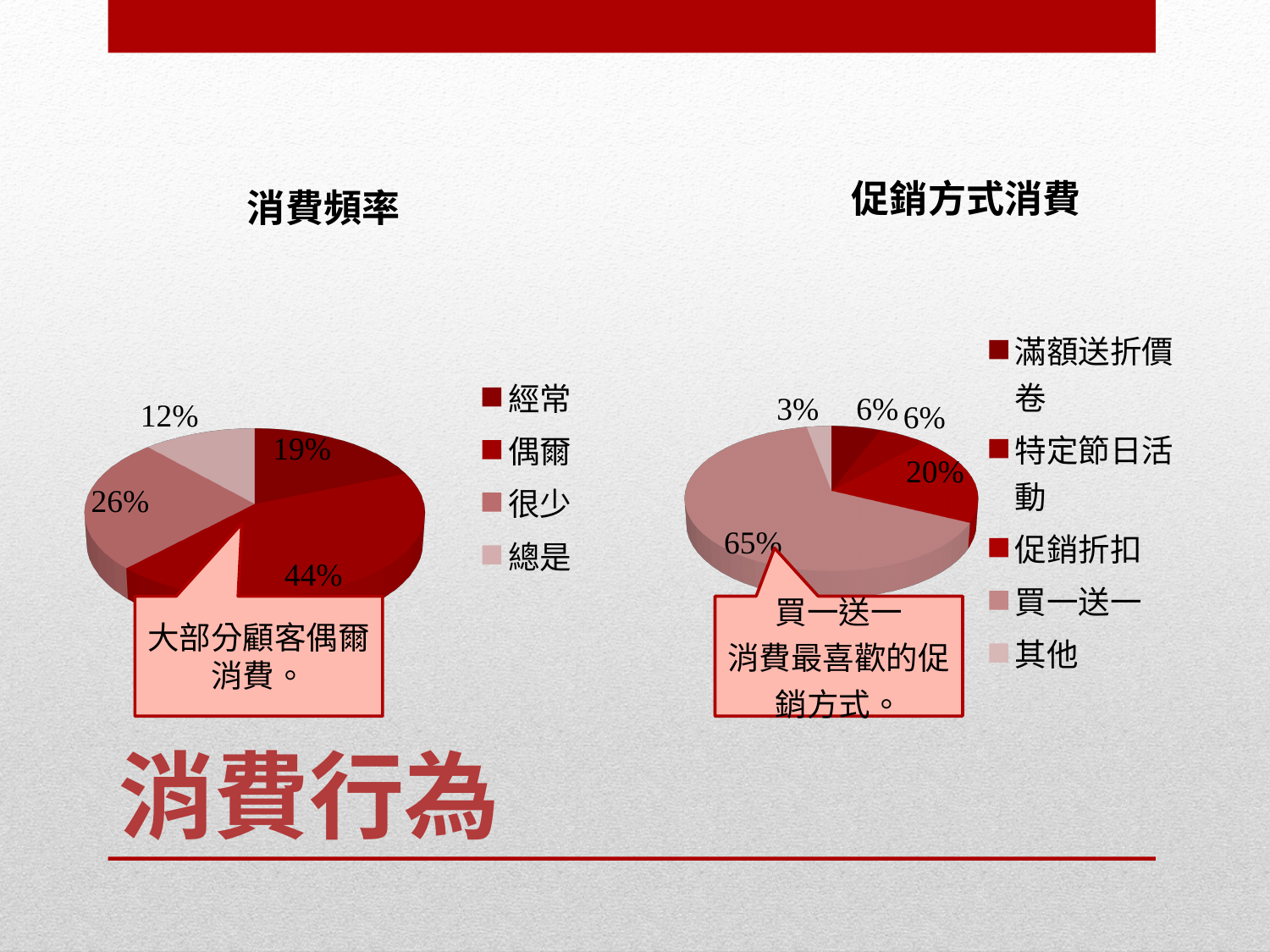
In the 促銷方式消費 chart, what percentage is shown for 促銷折扣? 20% In the 消費頻率 chart, which category has the smallest share? 總是 In the 促銷方式消費 chart, which is larger, 促銷折扣 or 其他? 促銷折扣 In the 消費頻率 chart, what percentage is shown for 偶爾? 44% In the 消費頻率 chart, what is the difference between the shares for 偶爾 and 很少? 18% In the 促銷方式消費 chart, how many categories does the legend list? 5 In the 促銷方式消費 chart, what percentage is shown for 買一送一? 65% In the 消費頻率 chart, what percentage is shown for 經常? 19% In the 促銷方式消費 chart, which category has the smallest share? 其他 In the 消費頻率 chart, how many categories does the legend list? 4 What type of chart is the 促銷方式消費 chart? Pie chart In the 消費頻率 chart, which category has the largest share? 偶爾